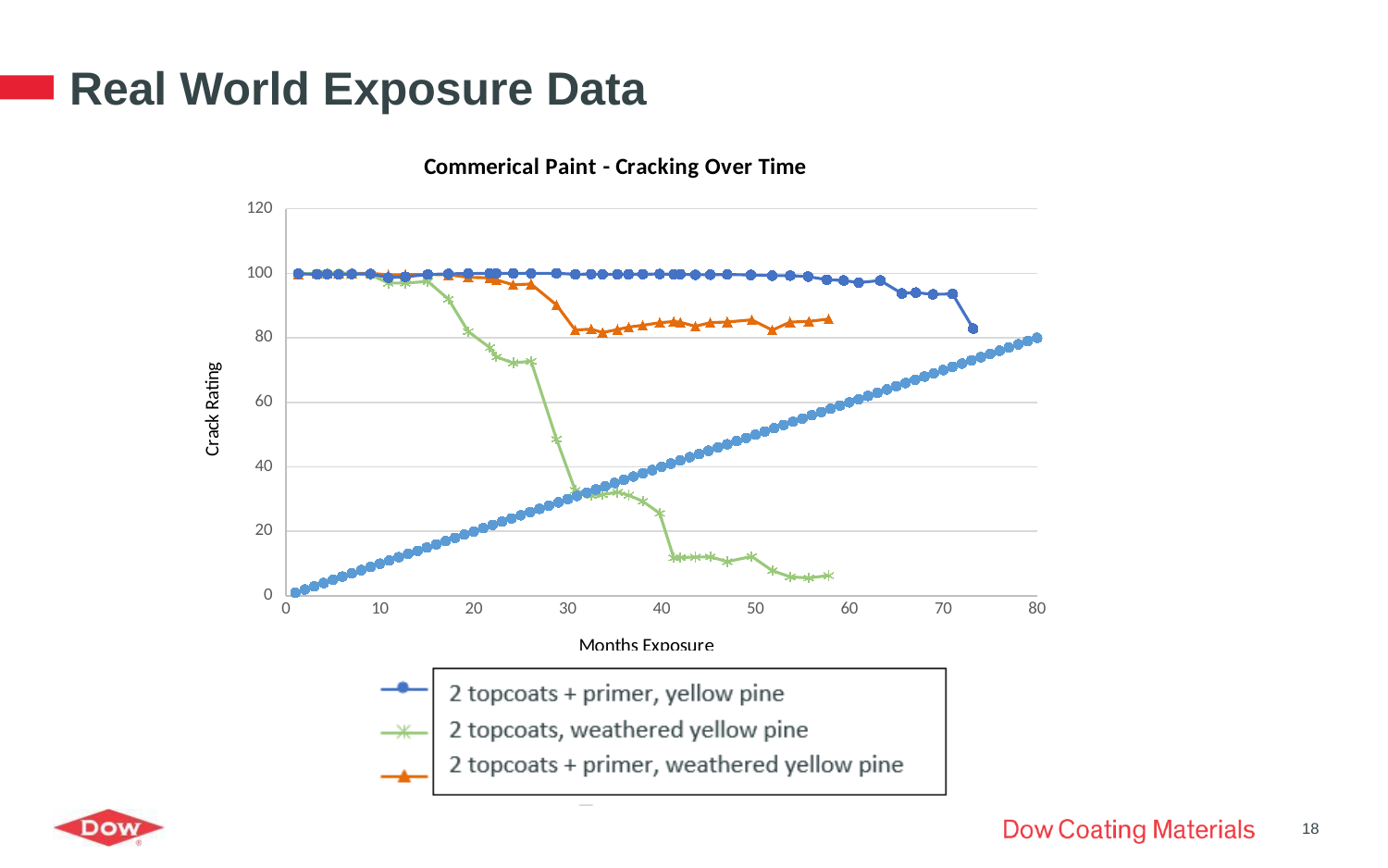
What is the label on the vertical axis of the chart? Crack Rating Is the crack rating for '2 topcoats, weathered yellow pine' at 50 months exposure greater or less than 20? less Is the crack rating for '2 topcoats, weathered yellow pine' at 40 months exposure greater or less than 40? less Is the crack rating for '2 topcoats + primer, weathered yellow pine' at 40 months exposure greater or less than 80? greater What is the title of the chart? Commerical Paint - Cracking Over Time At 40 months exposure, which has the higher crack rating: '2 topcoats + primer, weathered yellow pine' or '2 topcoats, weathered yellow pine'? 2 topcoats + primer, weathered yellow pine At 50 months exposure, which has the higher crack rating: '2 topcoats + primer, yellow pine' or '2 topcoats, weathered yellow pine'? 2 topcoats + primer, yellow pine Does the crack rating for '2 topcoats, weathered yellow pine' rise or fall as months of exposure increase? fall What kind of chart is shown on the slide? line chart Which legend series has the lowest crack rating at 50 months exposure? 2 topcoats, weathered yellow pine How many series does the legend list? 3